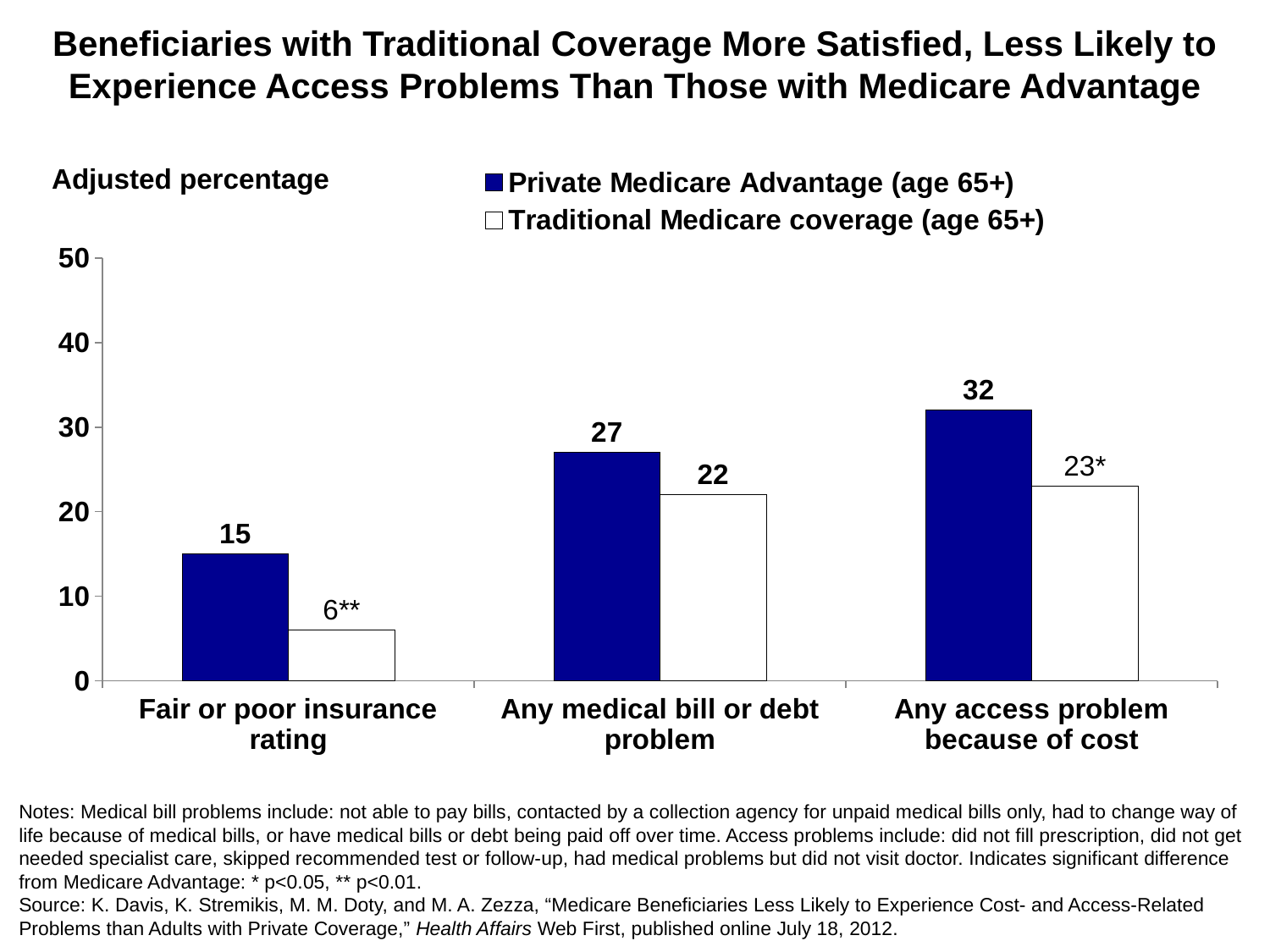
For 'Any medical bill or debt problem', which series has the larger value: Private Medicare Advantage or Traditional Medicare coverage? Private Medicare Advantage (age 65+) What is the value for Traditional Medicare coverage (age 65+) for 'Any medical bill or debt problem'? 22 Which category has the lowest value for Traditional Medicare coverage (age 65+)? Fair or poor insurance rating How many categories are shown on the x axis? 3 What is the value for Traditional Medicare coverage (age 65+) for 'Fair or poor insurance rating'? 6** Which category has the highest value for Private Medicare Advantage (age 65+)? Any access problem because of cost What is the value for Private Medicare Advantage (age 65+) for 'Any access problem because of cost'? 32 How many series does the legend list? 2 What is the value for Private Medicare Advantage (age 65+) for 'Fair or poor insurance rating'? 15 What is the label on the y axis of the chart? Adjusted percentage What is the difference between the Private Medicare Advantage and Traditional Medicare values for 'Any access problem because of cost'? 9 What kind of chart is shown on the slide? Bar chart